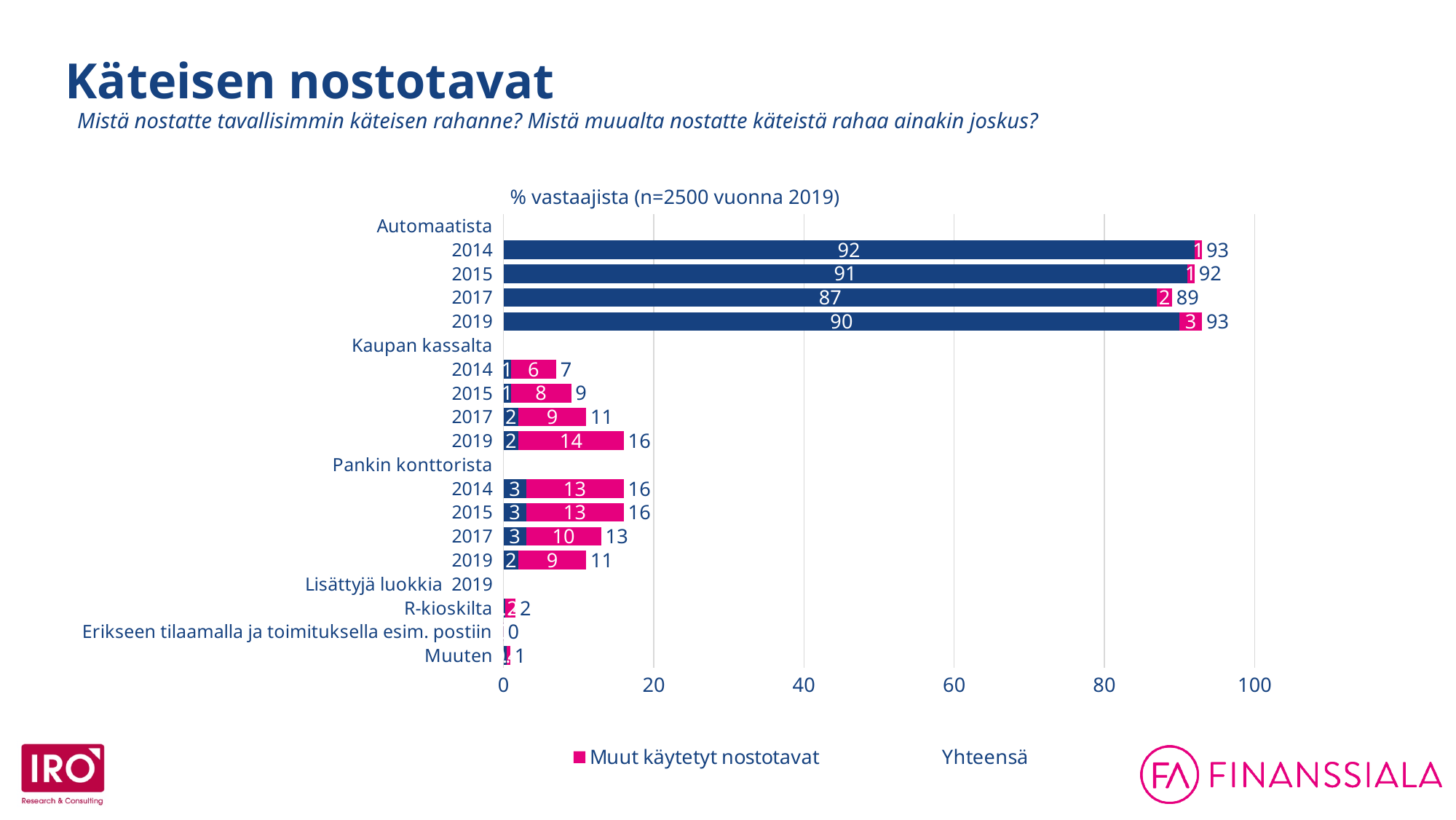
Do the Kaupan kassalta totals rise or fall from 2014 to 2019? rise Which series does the pink colour represent in the legend? Muut käytetyt nostotavat What kind of chart is shown on the slide? bar chart What is the total (Yhteensä) for Automaatista in 2017? 89 What is the chart's title? % vastaajista (n=2500 vuonna 2019) What is the total (Yhteensä) for Pankin konttorista in 2014? 16 What is the pink (Muut käytetyt nostotavat) value for Kaupan kassalta in 2019? 14 Which has the larger total in 2019, Kaupan kassalta or Pankin konttorista? Kaupan kassalta Among the Lisättyjä luokkia 2019 categories, which has the highest value? R-kioskilta What is the dark blue value for Automaatista in 2019? 90 What is the difference between the Automaatista totals for 2014 and 2017? 4 Do the Pankin konttorista totals rise or fall from 2014 to 2019? fall